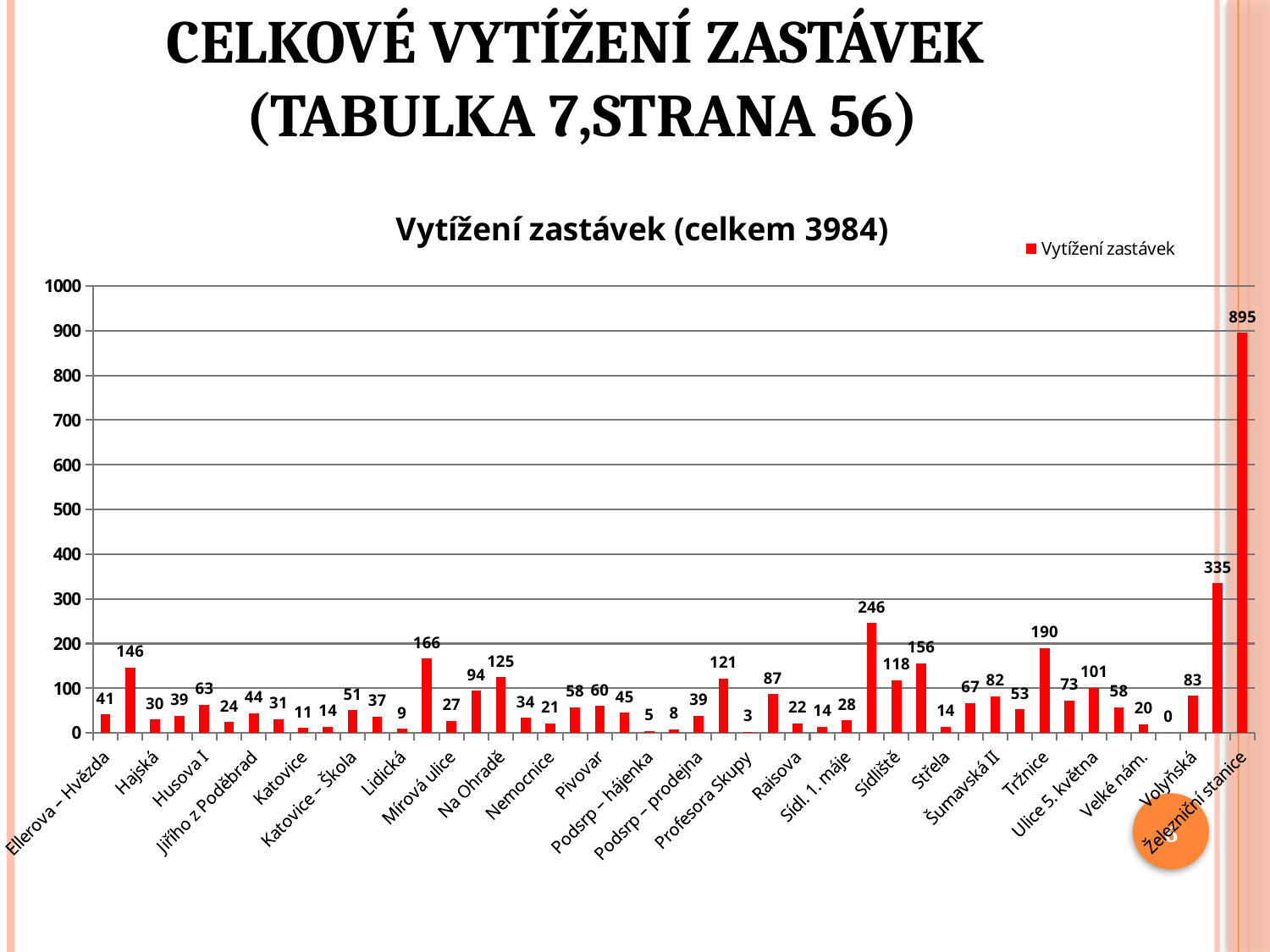
Which category has the highest value? Železniční stanice What type of chart is shown on the slide? bar chart What is the title of the chart? Vytížení zastávek (celkem 3984) How many series does the legend list? 1 What is the value for Ellerova – Hvězda? 41 What is the value for Volyňská? 83 Which is larger, the value for Železniční stanice or the value for Volyňská? Železniční stanice Is the value for Tržnice greater or less than 100? greater What is the value for Tržnice? 190 What is the smallest data label value shown on the chart? 0 What is the value for Železniční stanice? 895 What is the difference between the two tallest bars (895 and 335)? 560